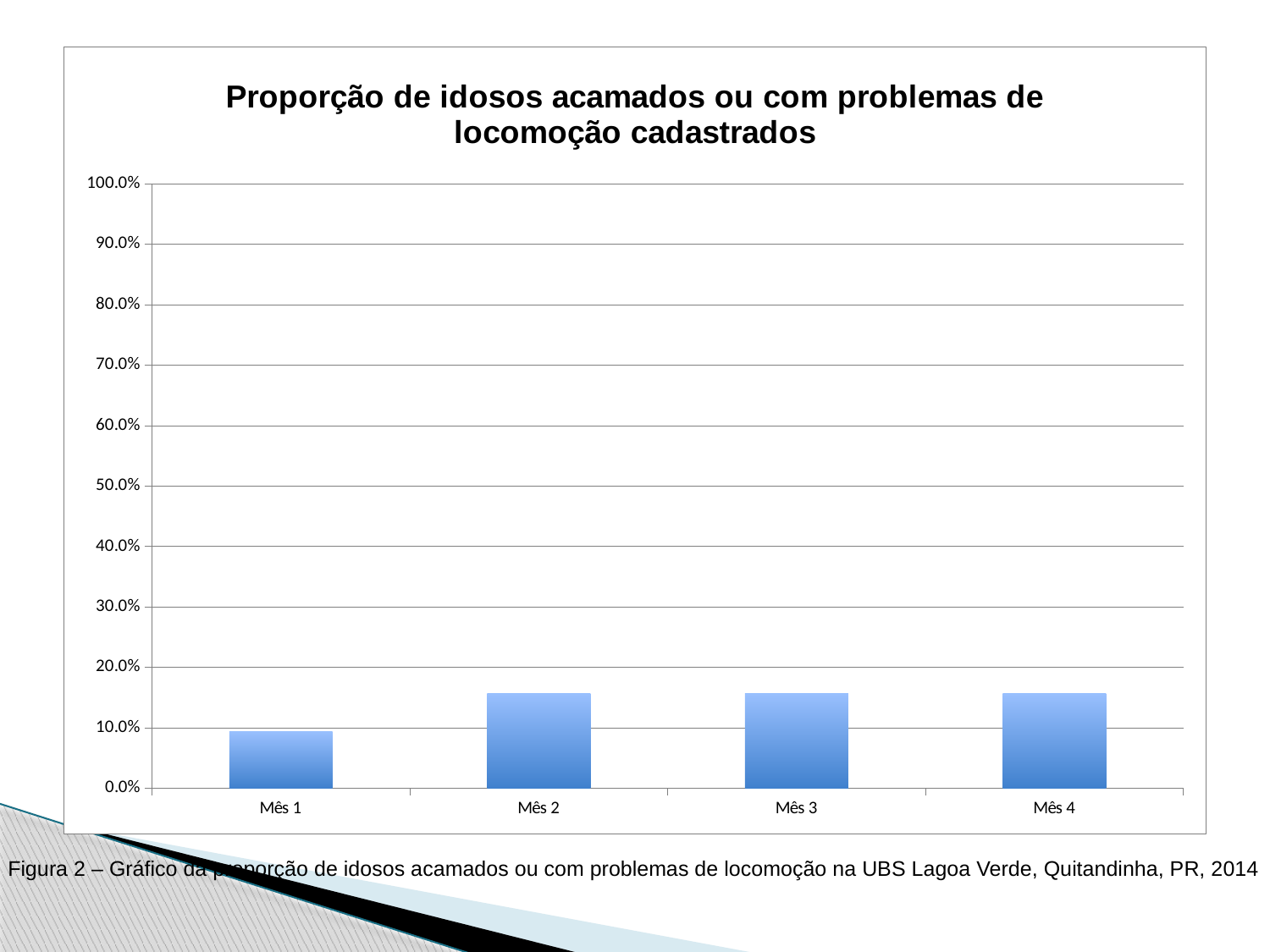
Does the value rise or fall from Mês 1 to Mês 2? rise Is the value for Mês 3 greater or less than 20.0%? less What is the title of the chart? Proporção de idosos acamados ou com problemas de locomoção cadastrados Which month has the lowest value in the chart? Mês 1 Is the value for Mês 4 greater or less than 50.0%? less How many categories (months) are shown on the x axis of the chart? 4 What kind of chart is shown on the slide? bar chart Is the value for Mês 2 greater or less than 10.0%? greater Which is larger, the value for Mês 1 or the value for Mês 2? Mês 2 What is the highest value shown on the y axis of the chart? 100.0% Which is larger, the value for Mês 1 or the value for Mês 4? Mês 4